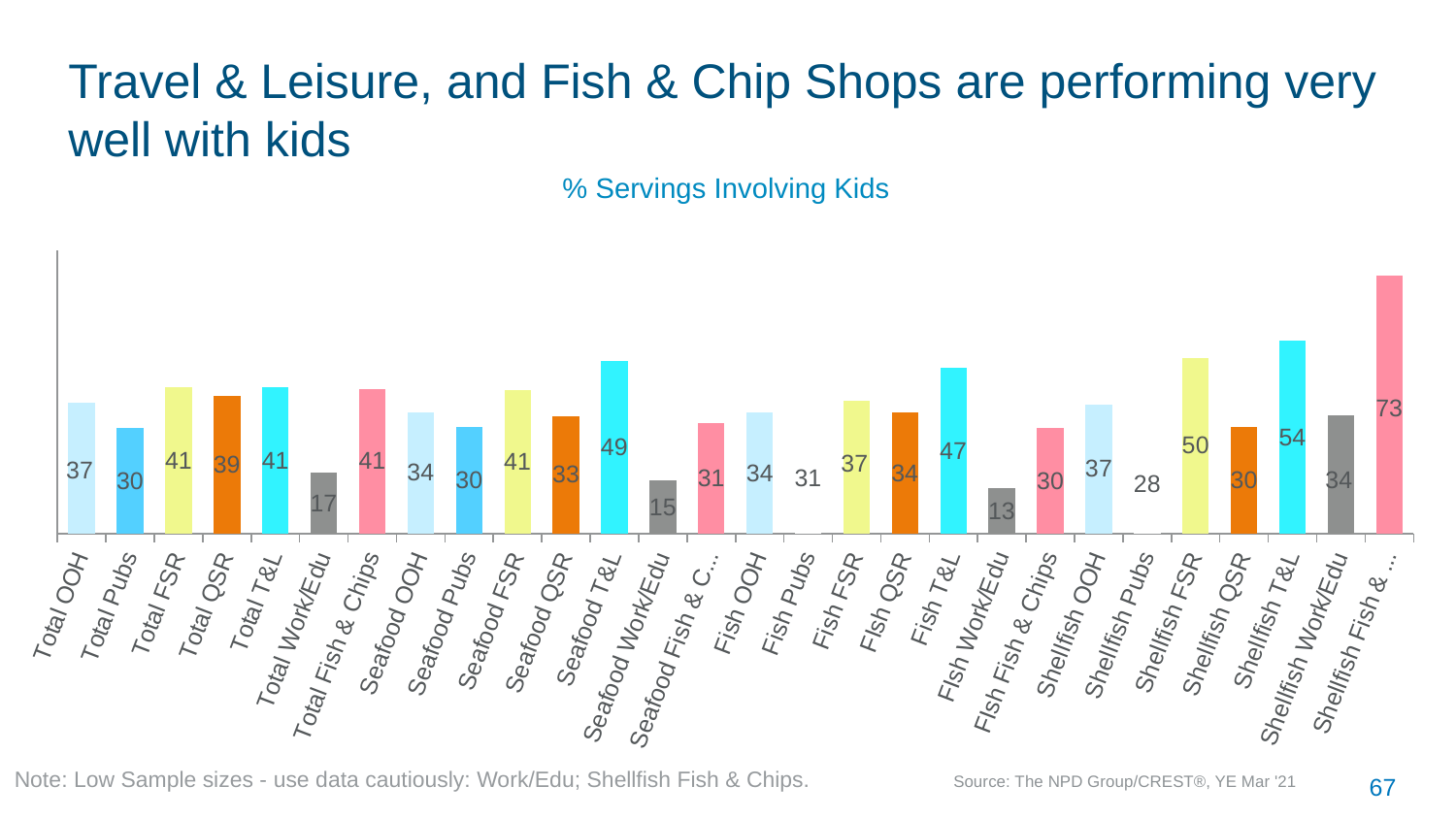
How many categories are shown on the x axis? 28 What is the difference between Shellfish T&L and Shellfish FSR? 4 What is the value for Total Work/Edu? 17 What is the value for Shellfish Work/Edu? 34 What is the value for Fish T&L? 47 What is the value for Seafood T&L? 49 What is the highest value shown in the chart? 73 Which is larger, Seafood T&L or Fish T&L? Seafood T&L What is the difference between Total FSR and Total Pubs? 11 Which category has the lowest value? Fish Work/Edu What kind of chart is shown? Bar chart What is the title of the chart? % Servings Involving Kids